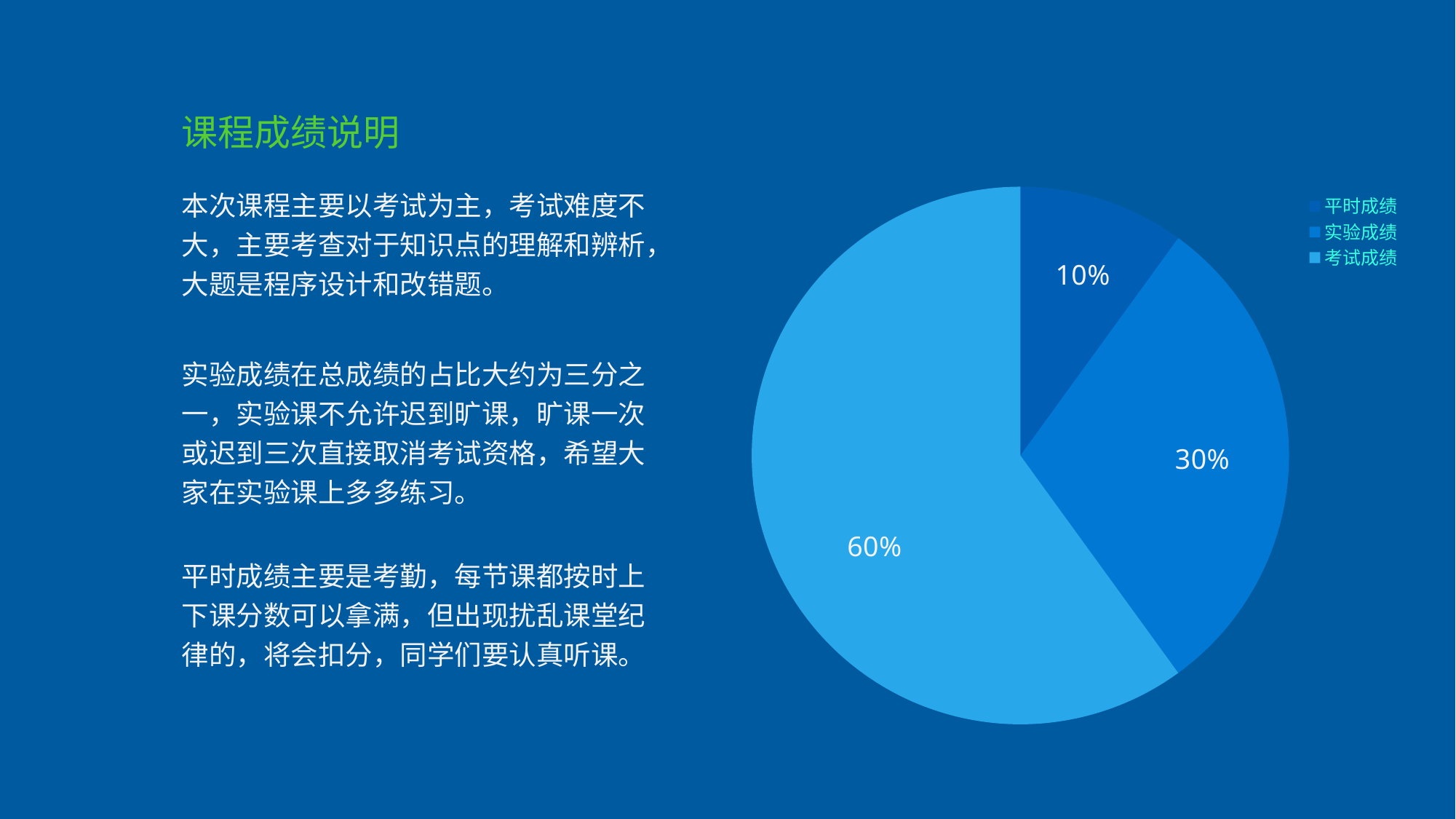
What is the difference in percentage points between 实验成绩 and 平时成绩? 20% Which category has the largest slice of the pie? 考试成绩 What kind of chart is shown on the slide? pie chart What share of the pie does 实验成绩 take? 30% What share of the pie does 平时成绩 take? 10% What share of the pie does 考试成绩 take? 60% Which category has the smallest slice of the pie? 平时成绩 How many slices does the pie chart have? 3 What is the difference in percentage points between 考试成绩 and 实验成绩? 30% Which is larger, the slice for 实验成绩 or the slice for 平时成绩? 实验成绩 How many entries does the legend list? 3 Which legend entry is listed first? 平时成绩